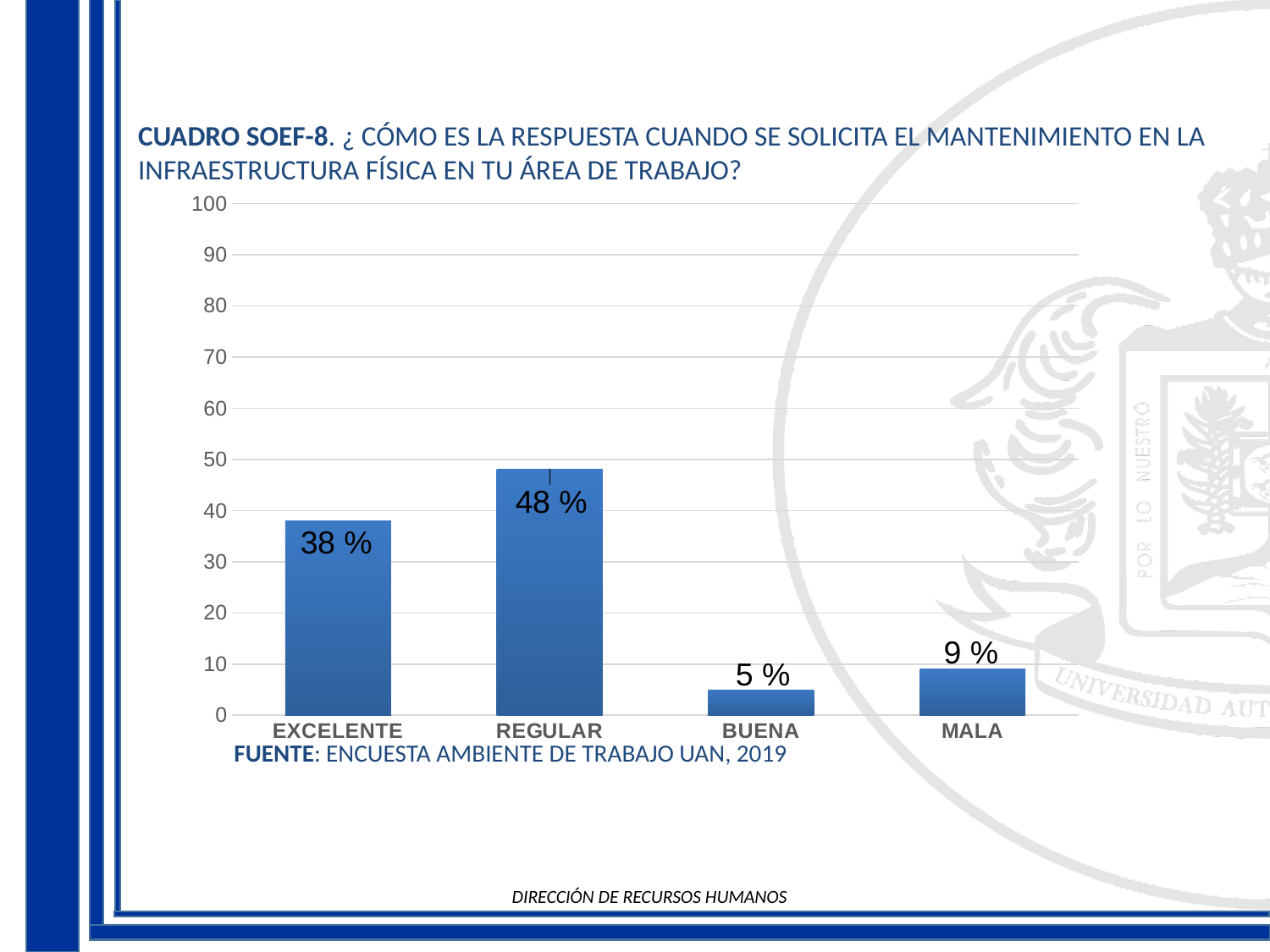
Is the value for EXCELENTE greater or less than 30? greater What is the value for EXCELENTE? 38 % What is the difference between the values for REGULAR and EXCELENTE? 10 % Which category has the highest value? REGULAR What is the value for REGULAR? 48 % How many categories are shown on the x axis? 4 Which category has the lowest value? BUENA What kind of chart is shown on the slide? bar chart What source is cited below the chart? ENCUESTA AMBIENTE DE TRABAJO UAN, 2019 Which is larger, the value for MALA or the value for BUENA? MALA What is the value for BUENA? 5 % What is the value for MALA? 9 %